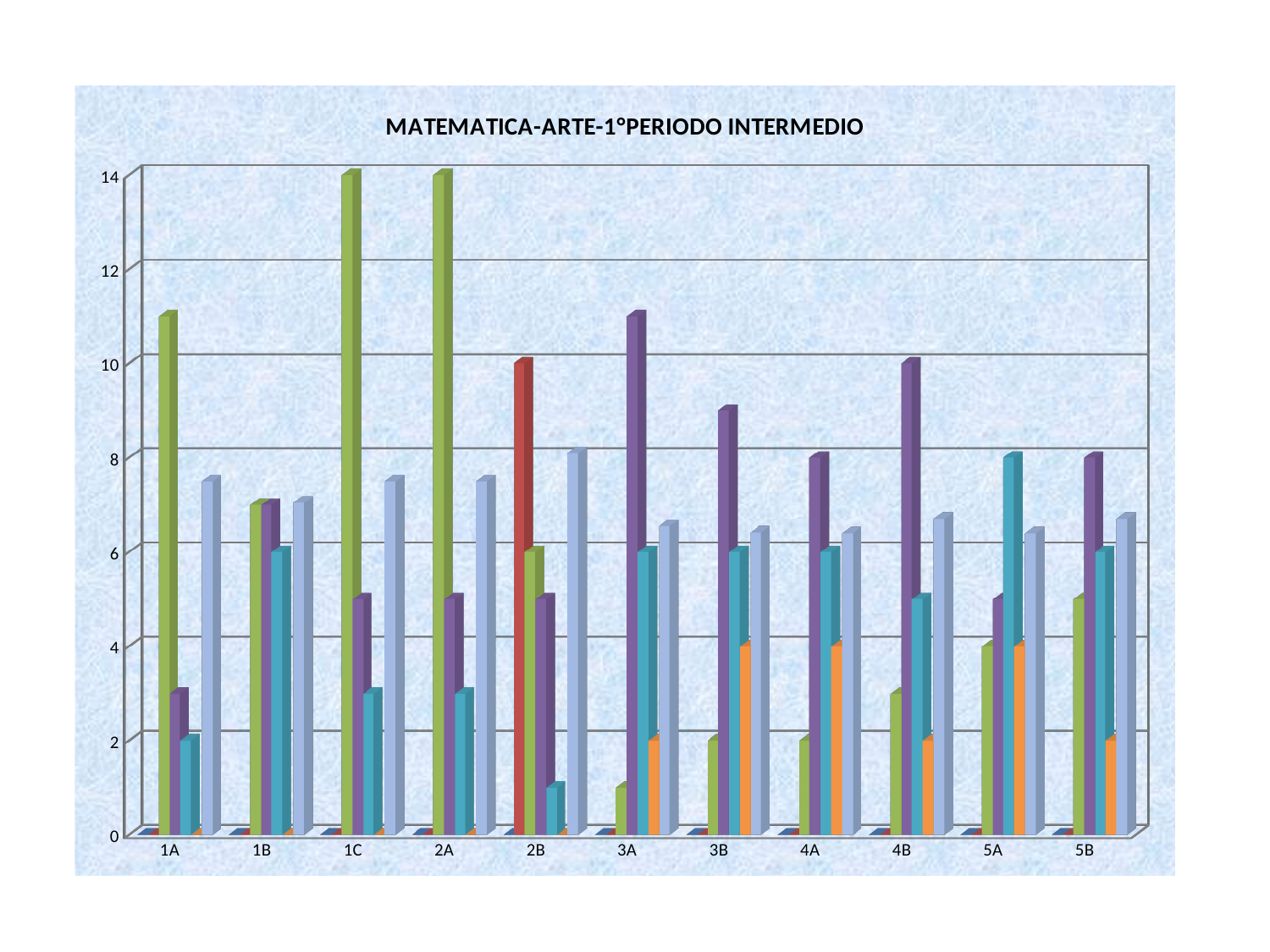
Which category has the taller green bar, 1A or 1B? 1A Is the green bar for 1A greater or less than 10? greater Is the purple bar for 1A greater or less than 4? less Is the green bar for 2A greater or less than 12? greater What kind of chart is shown on the slide? bar chart Which category has the taller teal bar, 5A or 1A? 5A In which category does the red bar appear? 2B How many categories are shown on the x axis of the chart? 11 What is the title of the chart? MATEMATICA-ARTE-1°PERIODO INTERMEDIO